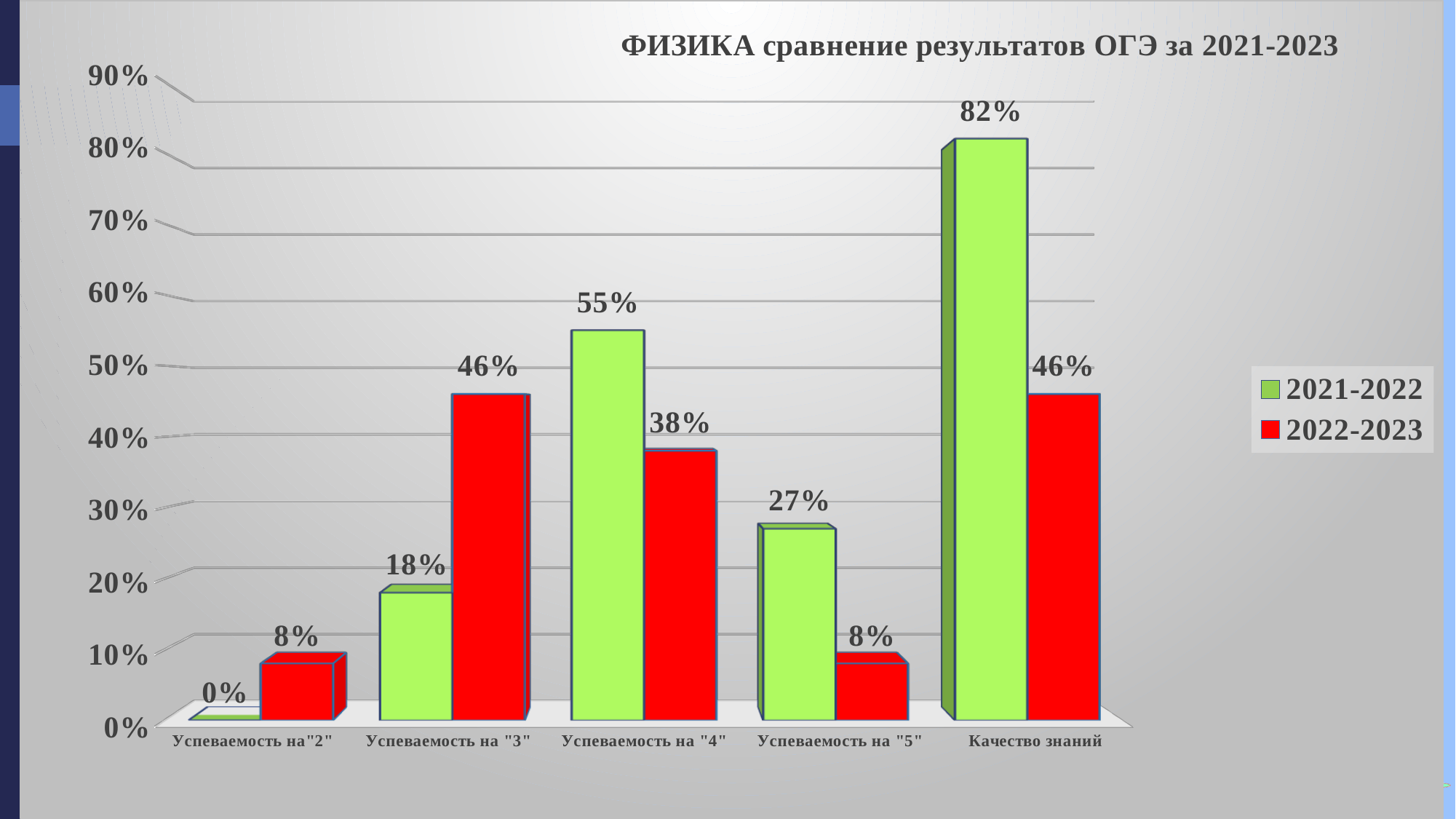
What kind of chart is shown on the slide? Bar chart Which category has the lowest value for the 2021-2022 series? Успеваемость на"2" Which category has the highest value for the 2021-2022 series? Качество знаний What is the title of the chart? ФИЗИКА сравнение результатов ОГЭ за 2021-2023 How many series does the legend list? 2 What is the value for 2021-2022 in the category Успеваемость на "4"? 55% What is the difference between the 2021-2022 and 2022-2023 values for Качество знаний? 36% What is the value for 2022-2023 in the category Успеваемость на "3"? 46% What is the value for 2021-2022 in the category Качество знаний? 82% How many categories are shown on the x axis? 5 Which is larger for Успеваемость на "3": the 2021-2022 value or the 2022-2023 value? 2022-2023 What is the value for 2022-2023 in the category Успеваемость на "5"? 8%